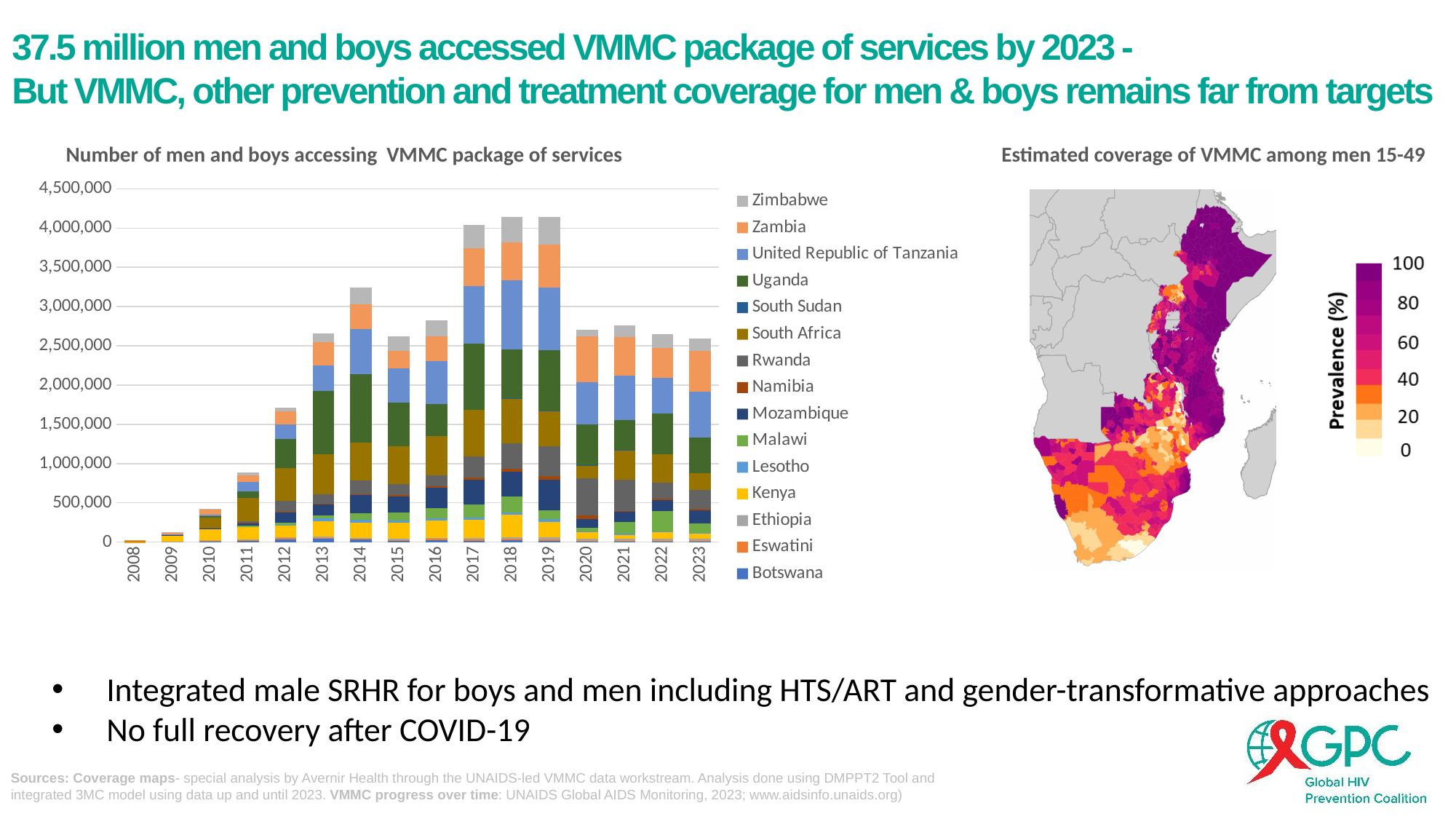
In the left bar chart, which year has the larger total: 2019 or 2020? 2019 What is the title of the map on the right of the slide? Estimated coverage of VMMC among men 15-49 In the left bar chart, is the total for 2012 greater or less than 2,000,000? less In the left bar chart, how many years are shown on the x axis? 16 In the left bar chart, is the total for 2014 greater or less than 3,000,000? greater In the left bar chart, is the total for 2018 greater or less than 4,000,000? greater In the left bar chart, which year has the larger total: 2014 or 2015? 2014 What kind of chart is the left chart titled 'Number of men and boys accessing VMMC package of services'? Stacked bar chart In the left bar chart, do the totals rise or fall from 2008 to 2014? rise In the left bar chart, how many countries does the legend list? 15 In the left bar chart, which year has the lowest total number of men and boys accessing VMMC services? 2008